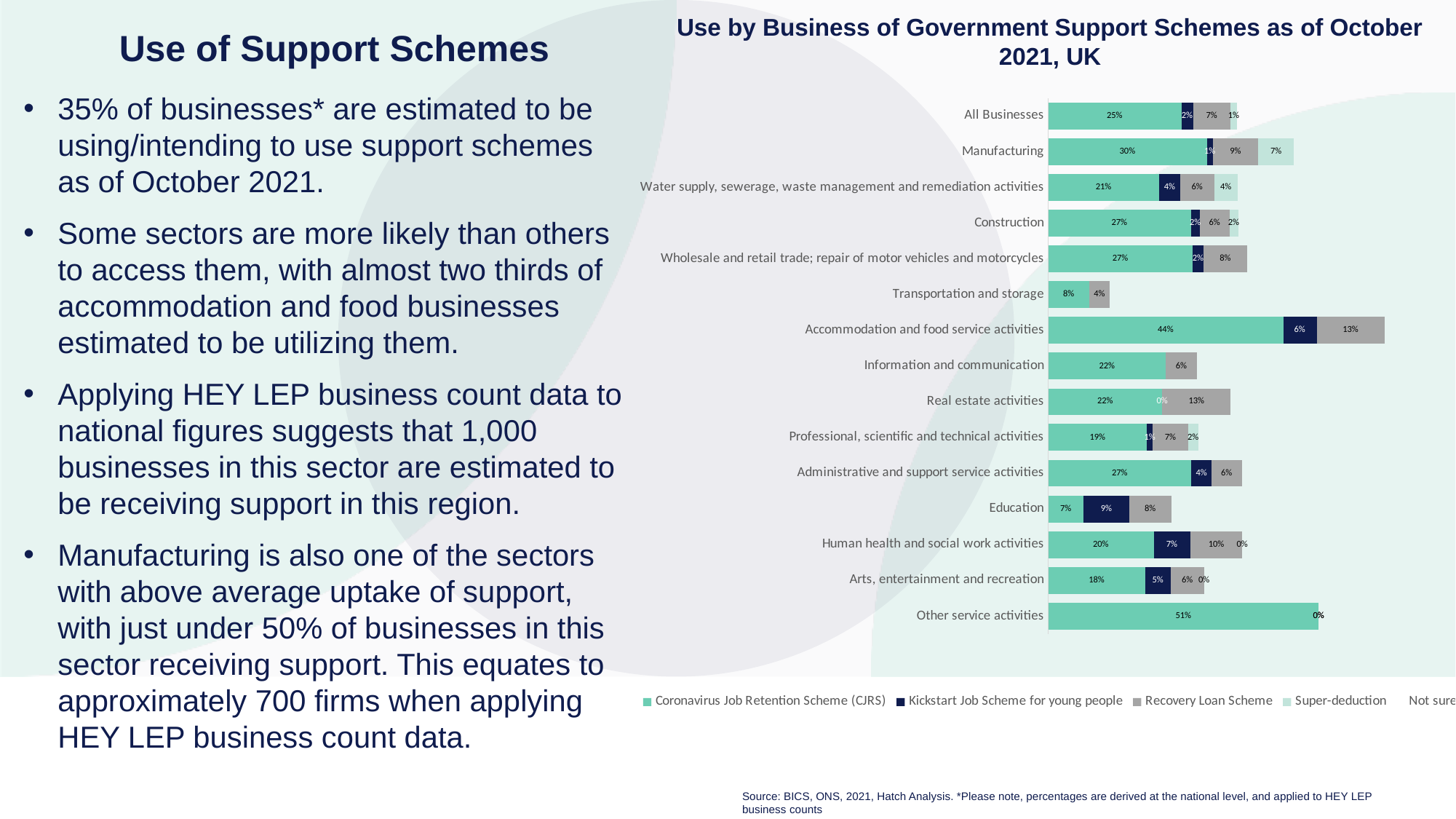
How many percentage points higher is the CJRS value for Accommodation and food service activities than for All Businesses? 19 percentage points How many support schemes does the chart legend list? 5 Which sector has the highest Coronavirus Job Retention Scheme (CJRS) value? Other service activities What is the Coronavirus Job Retention Scheme (CJRS) value for Manufacturing? 30% What type of chart is shown on the slide? Stacked bar chart Which sector has the lowest Coronavirus Job Retention Scheme (CJRS) value? Education What percentage of Accommodation and food service activities businesses use the Coronavirus Job Retention Scheme (CJRS)? 44% What is the Kickstart Job Scheme for young people value for Education? 9% What is the title of the chart? Use by Business of Government Support Schemes as of October 2021, UK What is the Recovery Loan Scheme value for Real estate activities? 13% How many sector categories are plotted on the chart? 15